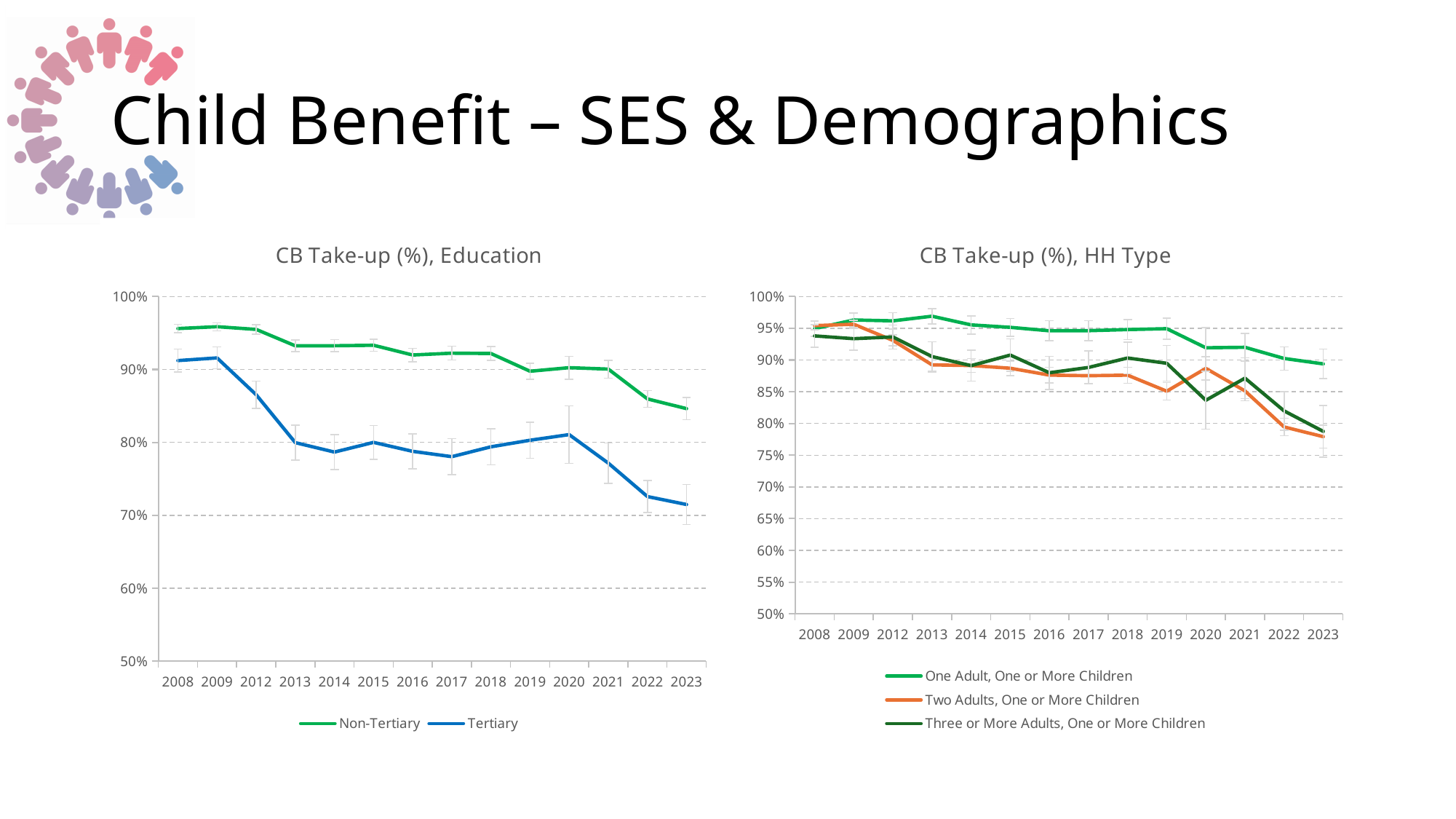
In the 'CB Take-up (%), Education' chart, which series has the higher value in 2023, Non-Tertiary or Tertiary? Non-Tertiary In the 'CB Take-up (%), Education' chart, does the Tertiary series generally rise or fall from 2008 to 2023? fall How many series does the legend of the 'CB Take-up (%), HH Type' chart list? 3 In the 'CB Take-up (%), HH Type' chart, is the value for Two Adults, One or More Children in 2023 greater or less than 80%? less In the 'CB Take-up (%), HH Type' chart, is the value for One Adult, One or More Children in 2013 greater or less than 95%? greater In the 'CB Take-up (%), Education' chart, is the value for Tertiary in 2023 greater or less than 80%? less How many years are shown on the x axis of the 'CB Take-up (%), Education' chart? 14 What kind of chart is the 'CB Take-up (%), Education' chart? line chart What is the title of the chart on the right of the slide? CB Take-up (%), HH Type In the 'CB Take-up (%), HH Type' chart, which series has the higher value in 2020, Two Adults, One or More Children or Three or More Adults, One or More Children? Two Adults, One or More Children How many series does the legend of the 'CB Take-up (%), Education' chart list? 2